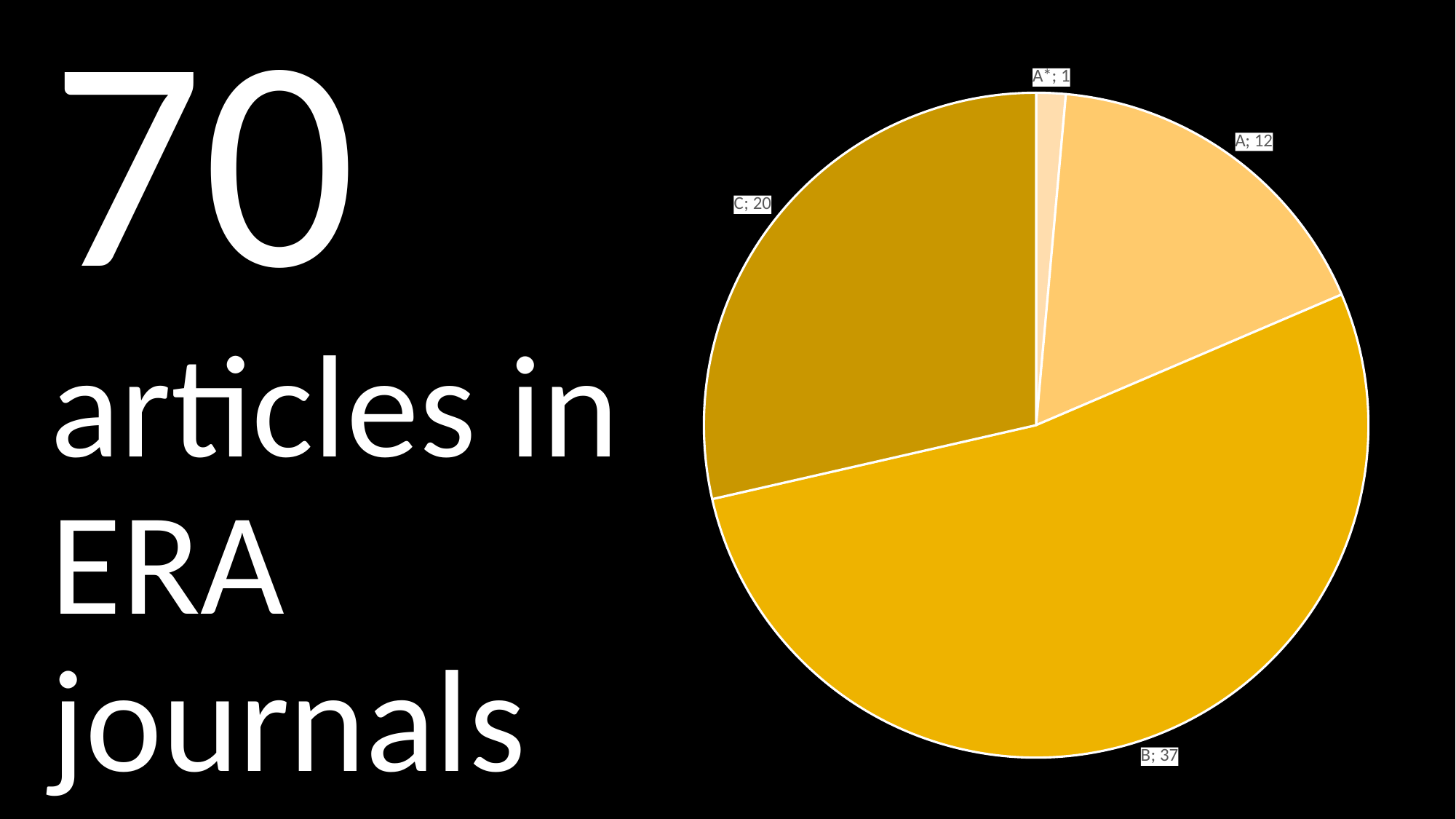
How many slices does the pie chart have? 4 What is the difference between the values for B and C? 17 Which category has the largest slice in the pie chart? B What kind of chart is shown on the slide? pie chart Which category has the smallest slice in the pie chart? A* Which is larger, the value for C or the value for A? C What is the total number of articles represented by the pie chart, according to the slide text? 70 What share of the pie does category B represent? 37/70 What is the value for category B in the pie chart? 37 What is the value for category A* in the pie chart? 1 What is the value for category A in the pie chart? 12 What is the value for category C in the pie chart? 20